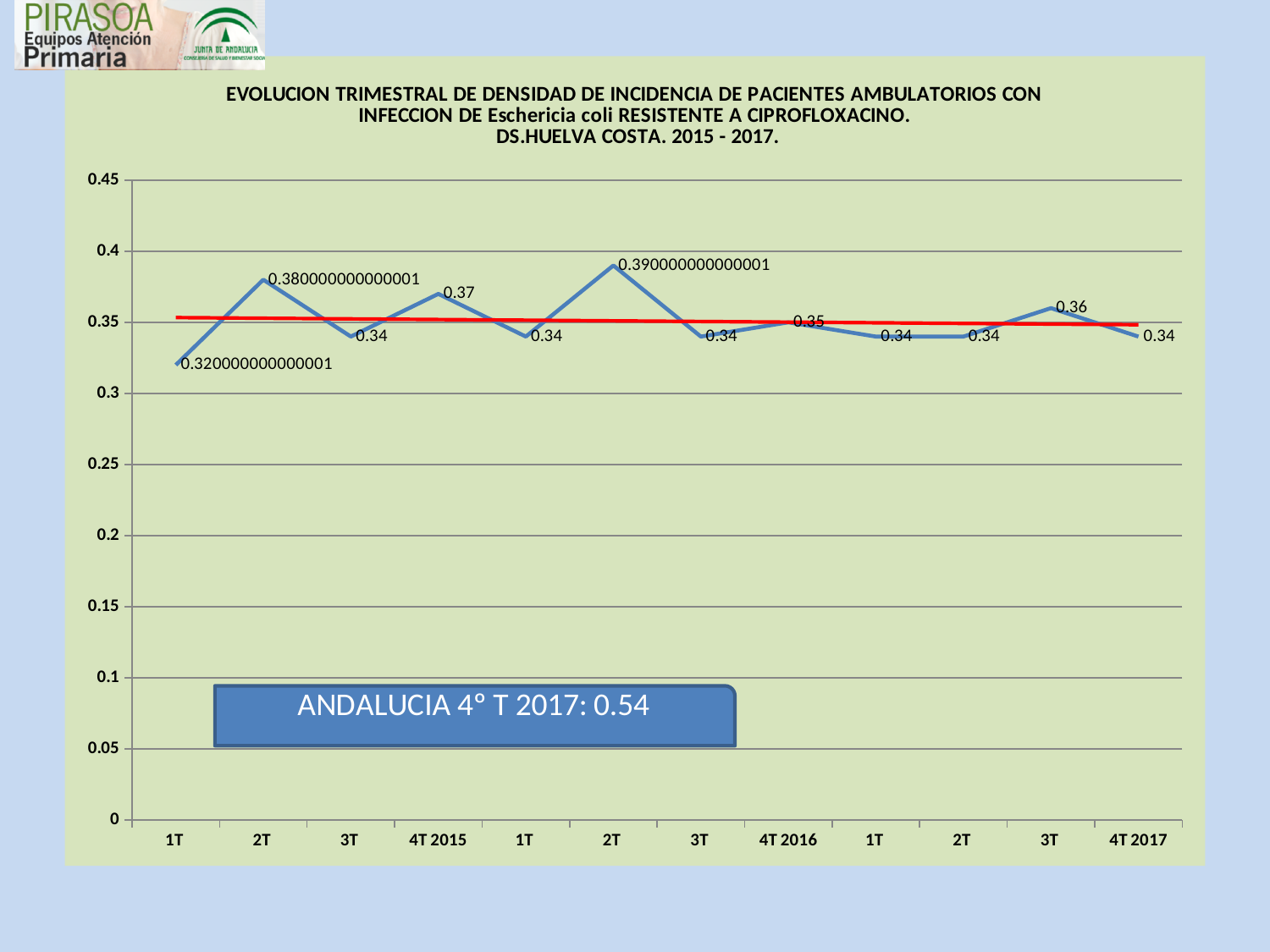
How many quarters are plotted on the x axis? 12 What is the value for 4T 2016? 0.35 What kind of chart is shown on the slide? Line chart Which quarter has the highest value on the chart? 2T 2016 What is the value for 4T 2017? 0.34 What value does the blue text box on the chart give for Andalucía in 4° T 2017? 0.54 What is the difference between the values for 4T 2015 and 4T 2016? 0.02 Which quarter has the lowest value on the chart? 1T 2015 What is the value for 3T of 2017 (the quarter just before 4T 2017)? 0.36 Which is larger, the value for 4T 2015 or the value for 3T 2017? 4T 2015 Is the value for 1T 2015 greater or less than 0.35? less What is the value for 4T 2015? 0.37